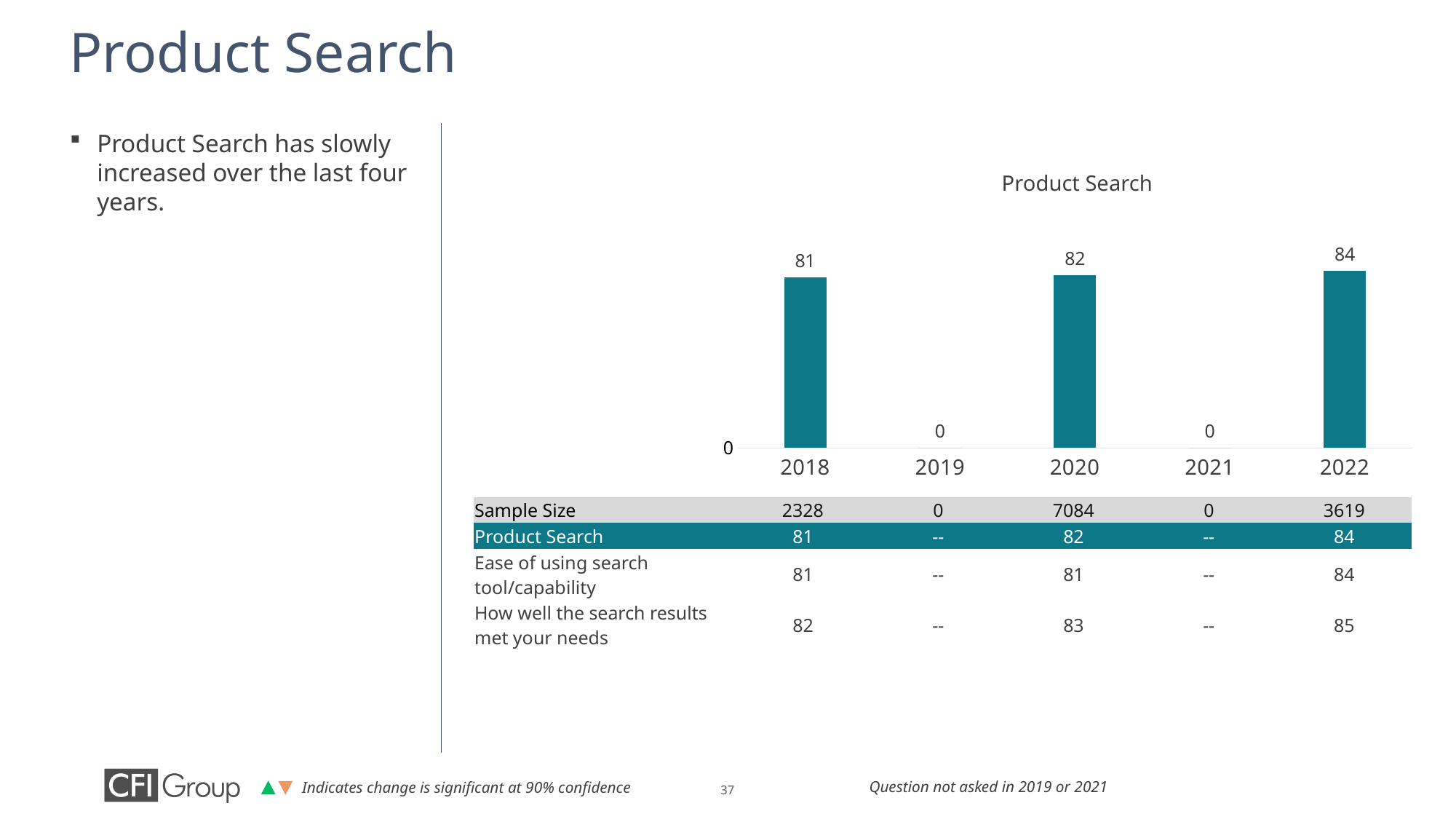
What value is shown for 2019 in the Product Search chart? 0 What is the value for 2018 in the Product Search chart? 81 Which is larger in the Product Search chart, the value for 2018 or the value for 2022? 2022 What is the title of the chart on the slide? Product Search What is the value for 2020 in the Product Search chart? 82 Which year has the highest value in the Product Search chart? 2022 Do the non-zero values in the Product Search chart rise or fall from 2018 to 2022? rise What kind of chart is the Product Search chart? bar chart What is the difference between the 2022 and 2018 values in the Product Search chart? 3 What is the difference between the 2022 and 2020 values in the Product Search chart? 2 What is the value for 2022 in the Product Search chart? 84 How many years are shown on the x axis of the Product Search chart? 5